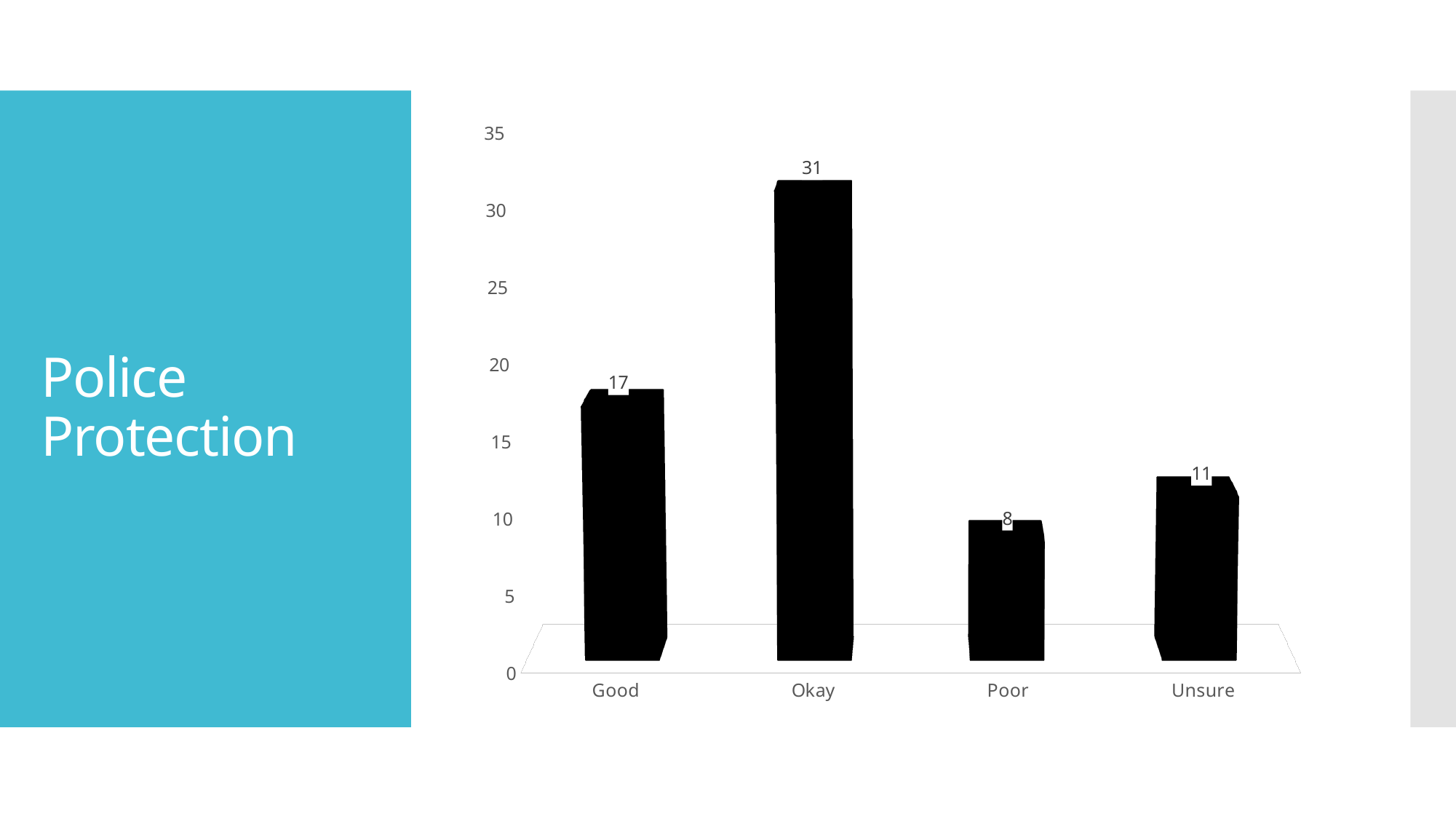
What is the value for Good? 17 Which category has the lowest value? Poor Which category has the highest value? Okay Is the value for Okay greater or less than 30? greater What kind of chart is shown on the slide? bar chart What is the value for Unsure? 11 How many categories are shown on the chart? 4 What is the difference between the values for Okay and Good? 14 Which is larger, the value for Good or the value for Unsure? Good What is the value for Poor? 8 What is the value for Okay? 31 What is the difference between the values for Unsure and Poor? 3